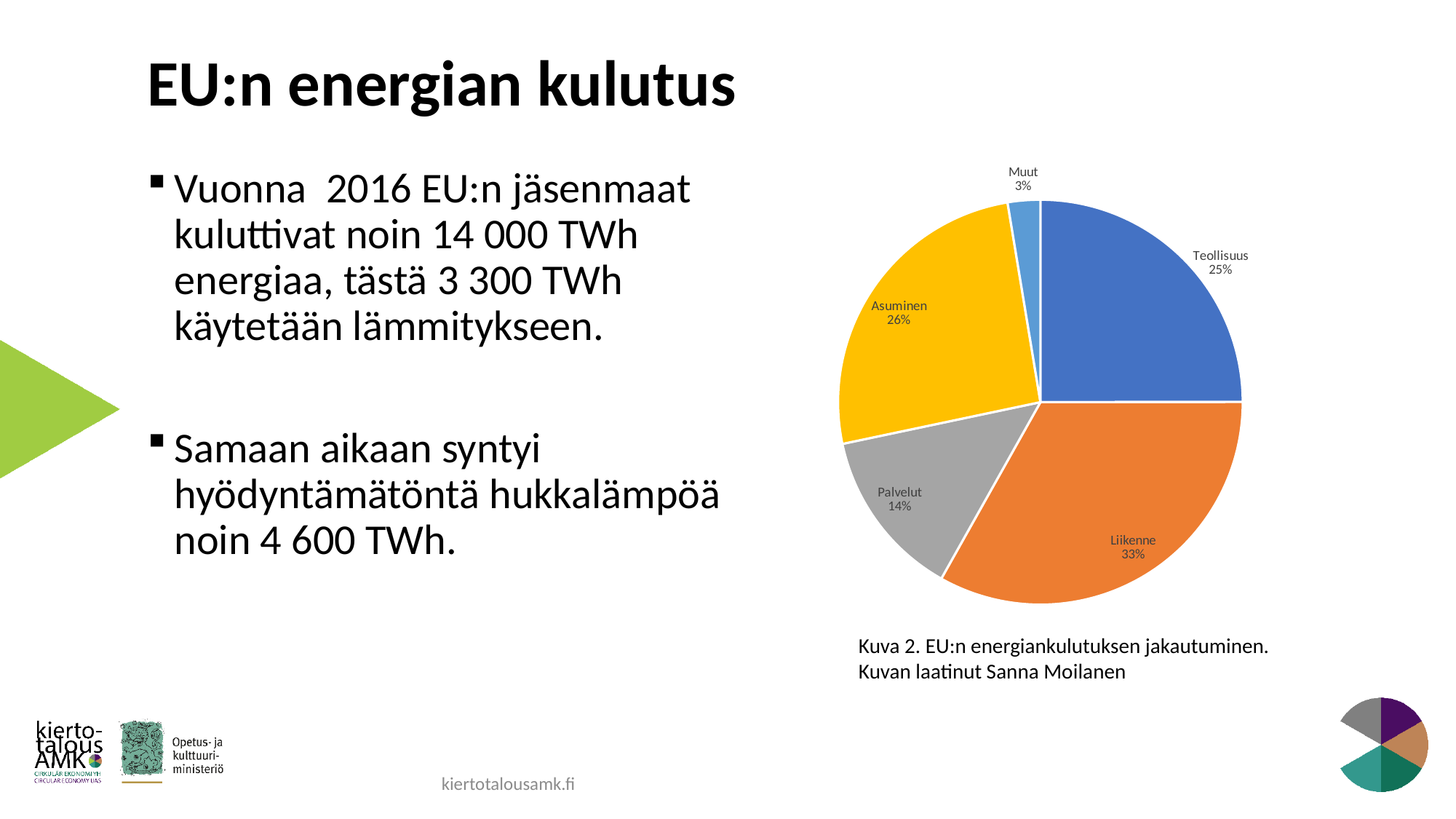
What is the difference in percentage points between Liikenne and Palvelut? 19 What colour is the Liikenne slice? Orange Which has a larger share, Liikenne or Teollisuus? Liikenne What share of the pie does Palvelut have? 14% What share of the pie does Muut have? 3% Which category has the smallest share of the pie? Muut Which category has the largest share of the pie? Liikenne What share of the pie does Teollisuus have? 25% What share of the pie does Asuminen have? 26% What share of the pie does Liikenne have? 33% How many categories are shown in the pie chart? 5 What kind of chart is shown on the slide? Pie chart